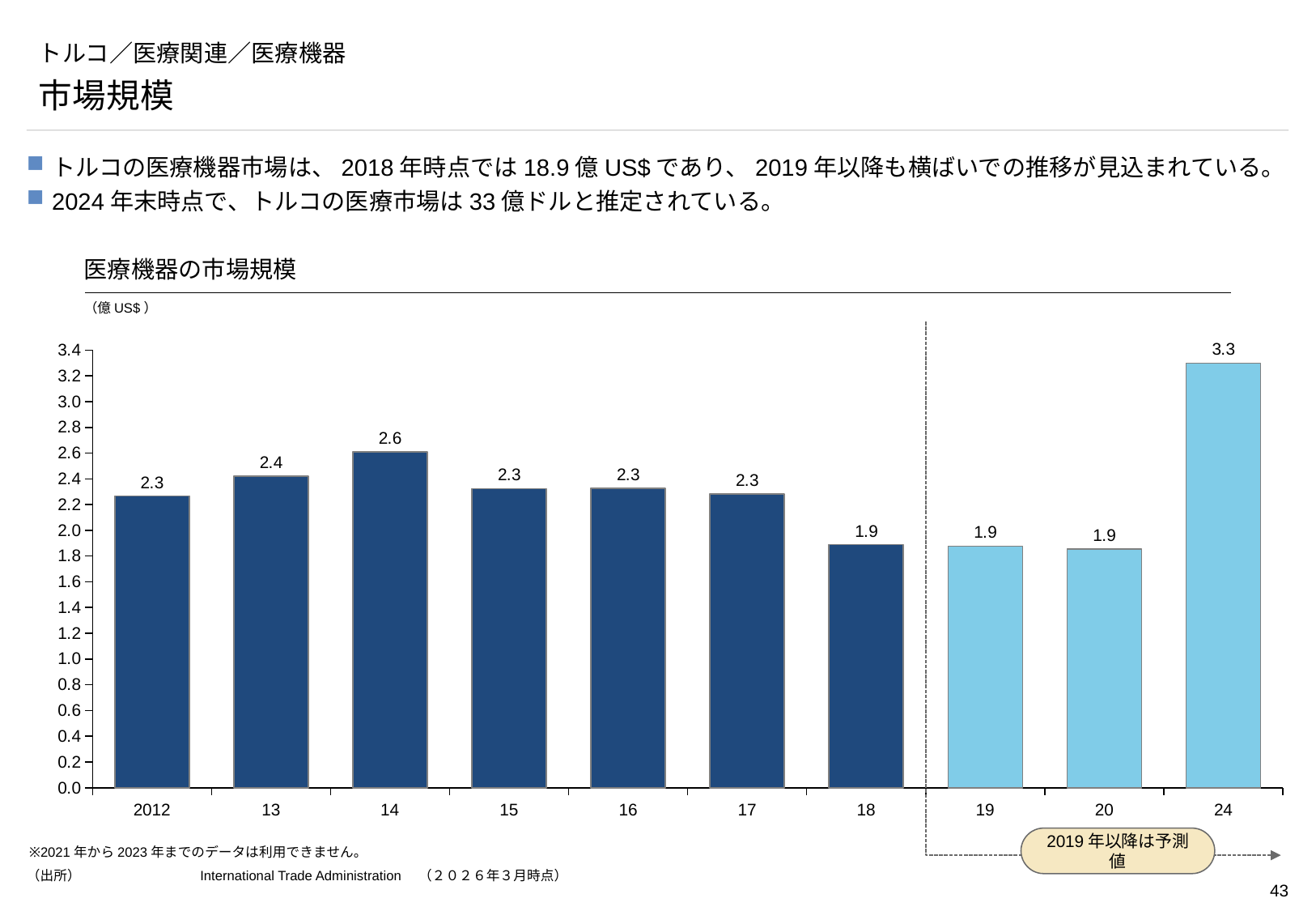
From 2014 to 2018, do the values rise or fall? fall What is the value for 2018 in the chart? 1.9 What is the value for 2014 in the 医療機器の市場規模 chart? 2.6 Which year has the highest value in the chart? 24 Which is larger, the value for 13 or the value for 14? 14 How many bars (years) are shown in the chart? 10 What is the difference between the values for 24 and 18? 1.4 What kind of chart is shown on the slide? bar chart What is the difference between the values for 2014 and 2018? 0.7 What unit is shown for the values in the chart? 億US$ What is the value for 24 (2024) in the chart? 3.3 Is the value for 24 greater or less than 3.0? greater